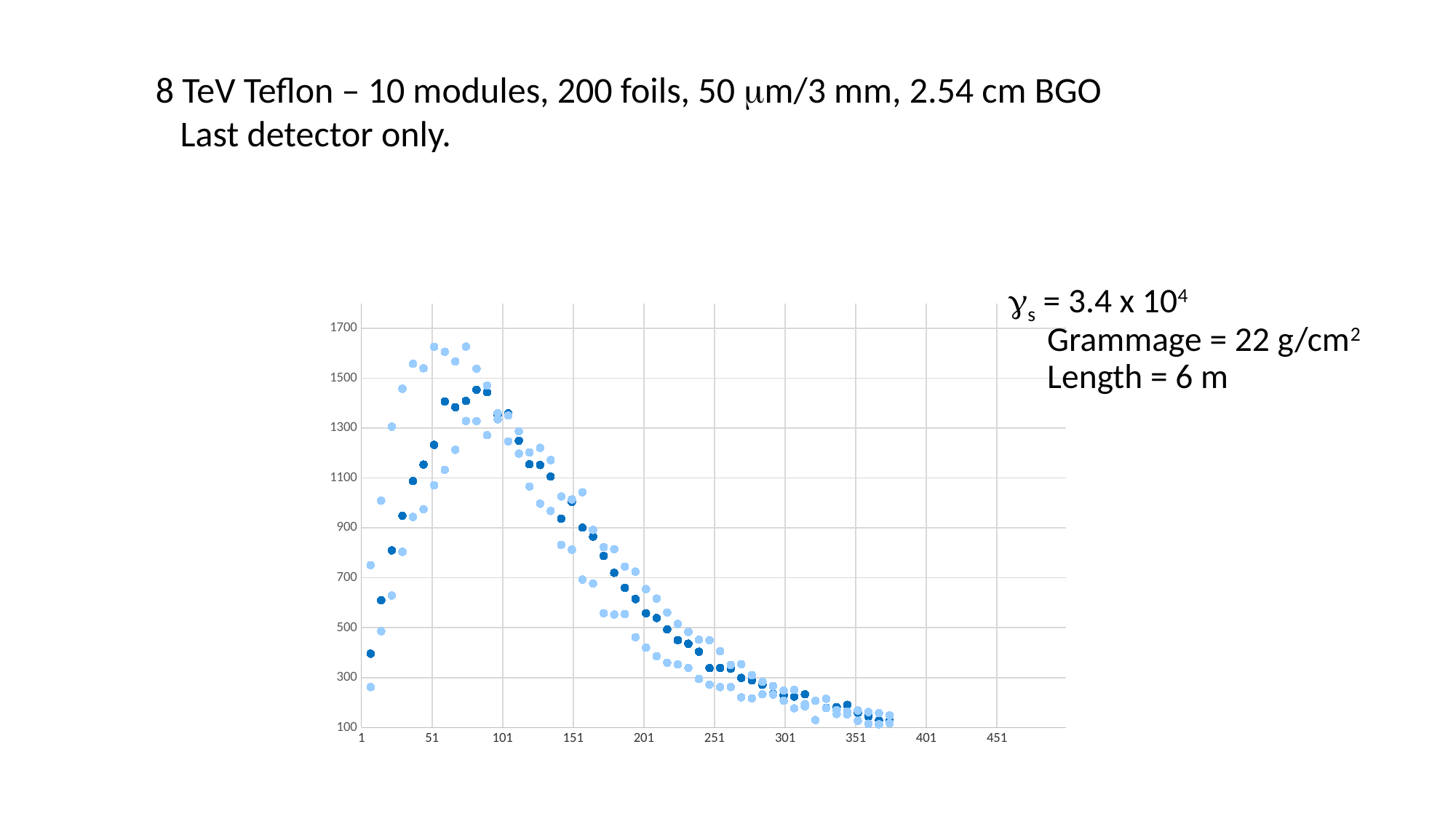
Are the dark blue points near x = 351 greater or less than 300? less What is the highest tick label shown on the y axis? 1700 What is the largest tick label shown on the x axis? 451 Is the dark blue point at x = 201 greater or less than 700? less Is the highest dark blue point on the chart greater or less than 1300? greater Do the plotted values rise or fall along the x axis between x = 1 and x = 51? rise Do the plotted values rise or fall along the x axis from x = 101 onward? fall What kind of chart is shown on the slide? scatter chart